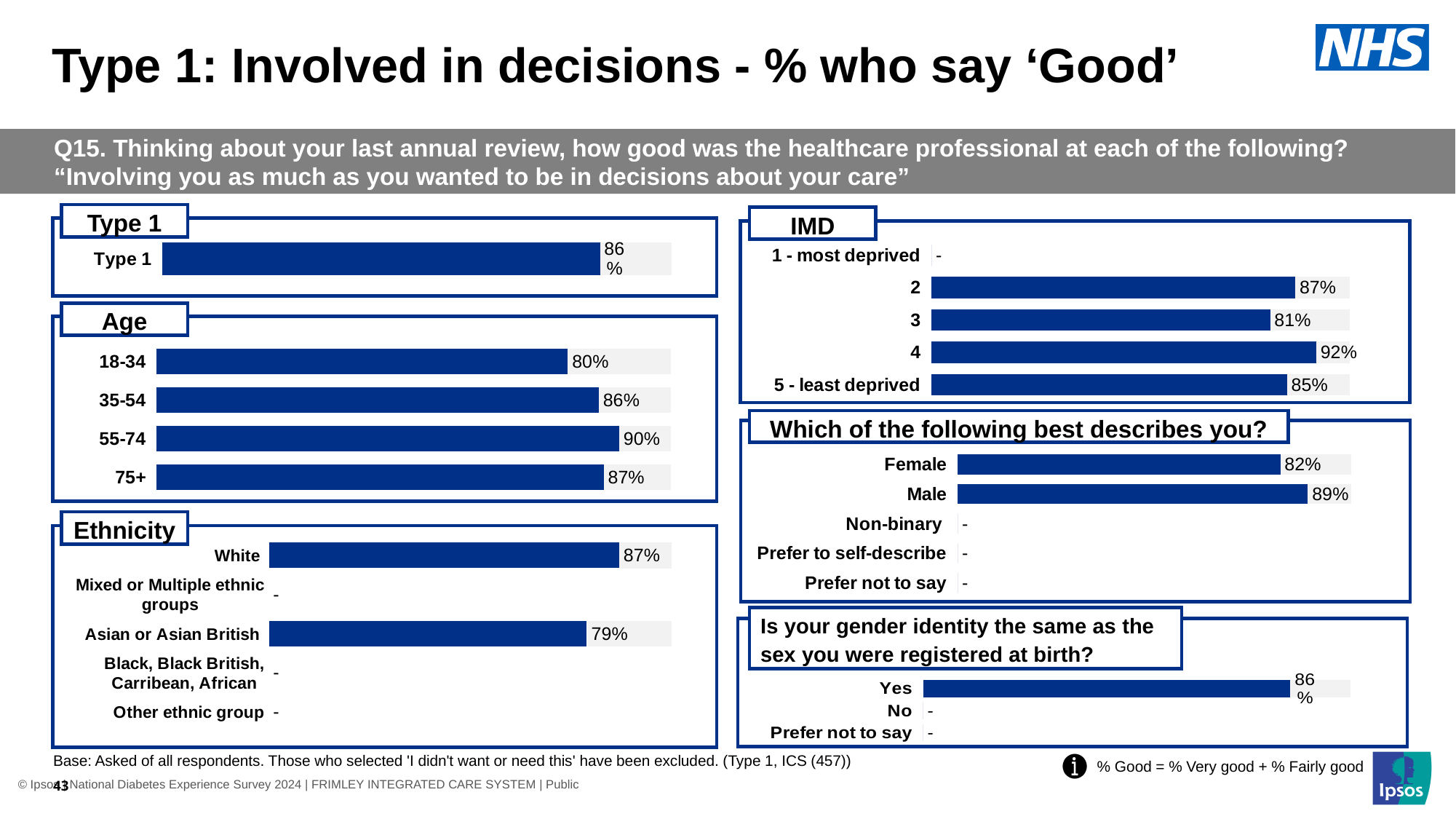
In the IMD chart, what is the difference between group 4 and group 3? 11 percentage points What type of chart is used in the Age section? Bar chart In the 'Which of the following best describes you?' chart, what is the value for Male? 89% In the Age chart, what is the difference between the 55-74 and 18-34 values? 10 percentage points In the Type 1 chart, what percentage of Type 1 respondents say 'Good'? 86% In the Age chart, how many age groups are shown? 4 In the IMD chart, which deprivation group has the highest percentage? 4 In the Age chart, what is the value for the 55-74 age group? 90% In the Ethnicity chart, which is larger, White or Asian or Asian British? White In the Age chart, which age group has the lowest percentage? 18-34 In the Ethnicity chart, what is the value for Asian or Asian British? 79% In the IMD chart, what is the value for 3? 81%